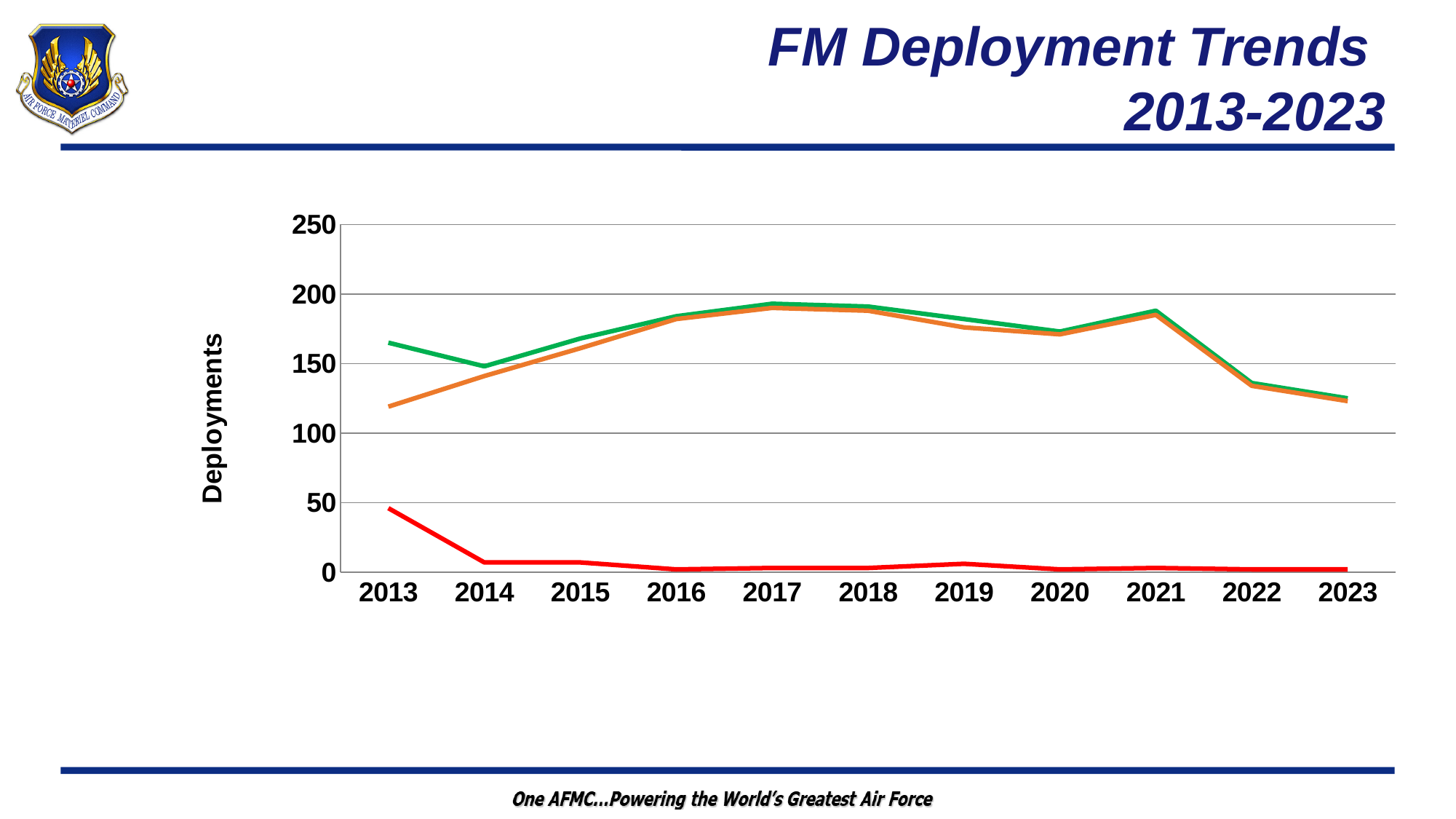
What kind of chart is shown on the slide? line chart What is the label on the vertical axis of the chart? Deployments Is the value of the green line in 2017 greater or less than 200? less Does the green line rise or fall from 2021 to 2023? fall How many years are shown along the x axis of the chart? 11 How many lines are plotted on the chart? 3 Is the value of the orange line in 2013 greater or less than 150? less What is the title of the chart on the slide? FM Deployment Trends 2013-2023 Is the value of the green line in 2013 greater or less than 150? greater In 2013, which line has the larger value, the green line or the orange line? green line In which year does the red line reach its highest value? 2013